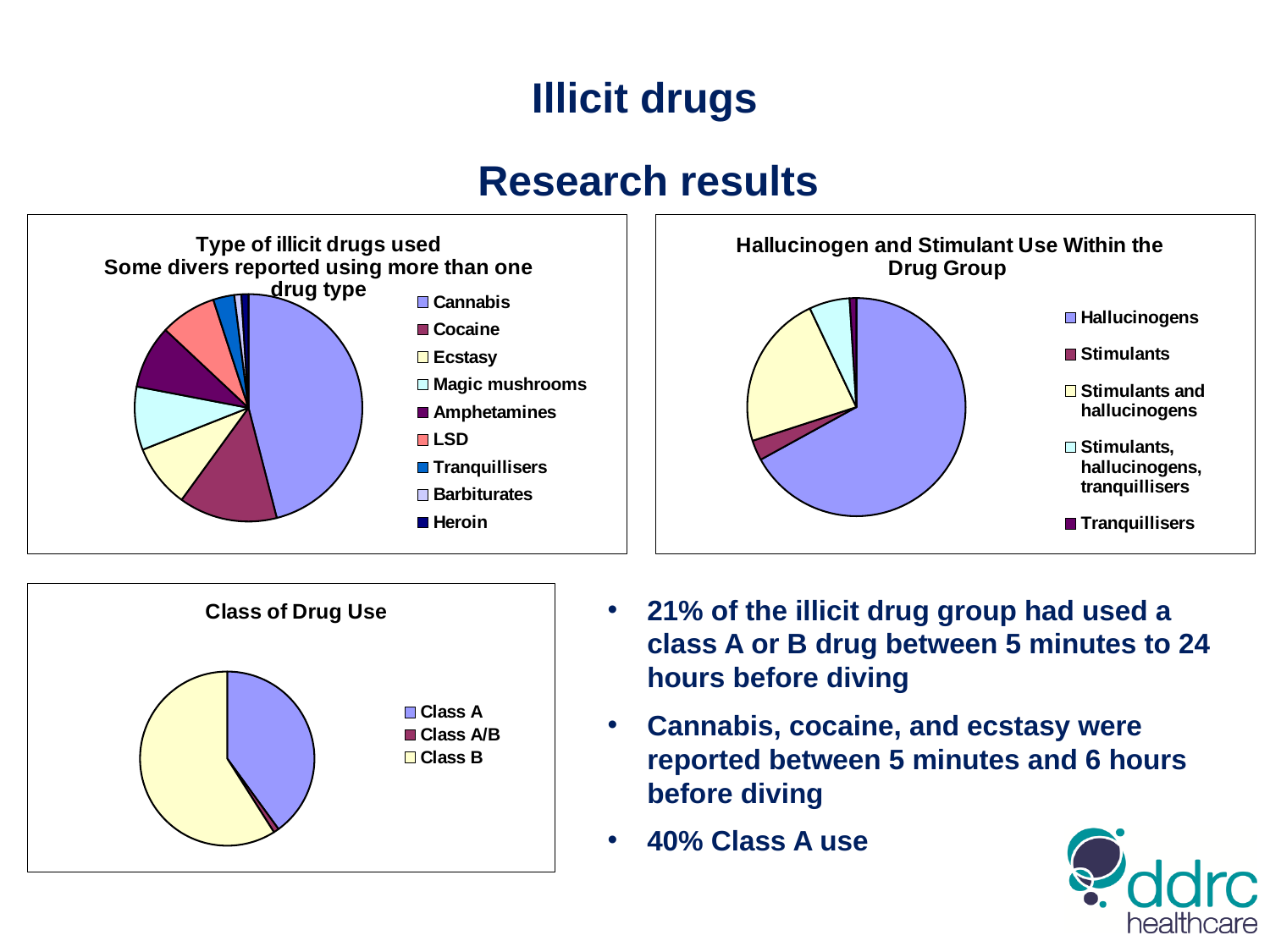
What is the title of the pie chart in the top right of the slide? Hallucinogen and Stimulant Use Within the Drug Group In the 'Class of Drug Use' chart, which class has the smallest slice? Class A/B In the 'Hallucinogen and Stimulant Use Within the Drug Group' chart, which slice is larger, 'Stimulants' or 'Stimulants and hallucinogens'? Stimulants and hallucinogens In the 'Hallucinogen and Stimulant Use Within the Drug Group' chart, how many categories are shown? 5 In the 'Class of Drug Use' chart, which class has the largest slice? Class B In the 'Type of illicit drugs used' chart, which slice is larger, Cocaine or LSD? Cocaine In the 'Hallucinogen and Stimulant Use Within the Drug Group' chart, which category has the smallest slice? Tranquillisers In the 'Hallucinogen and Stimulant Use Within the Drug Group' chart, which category has the largest slice? Hallucinogens In the 'Type of illicit drugs used' chart, which slice is larger, Cannabis or Cocaine? Cannabis In the 'Type of illicit drugs used' chart, how many drug types does the legend list? 9 What kind of chart is the 'Class of Drug Use' chart? Pie chart In the 'Type of illicit drugs used' chart, which drug type has the largest slice? Cannabis